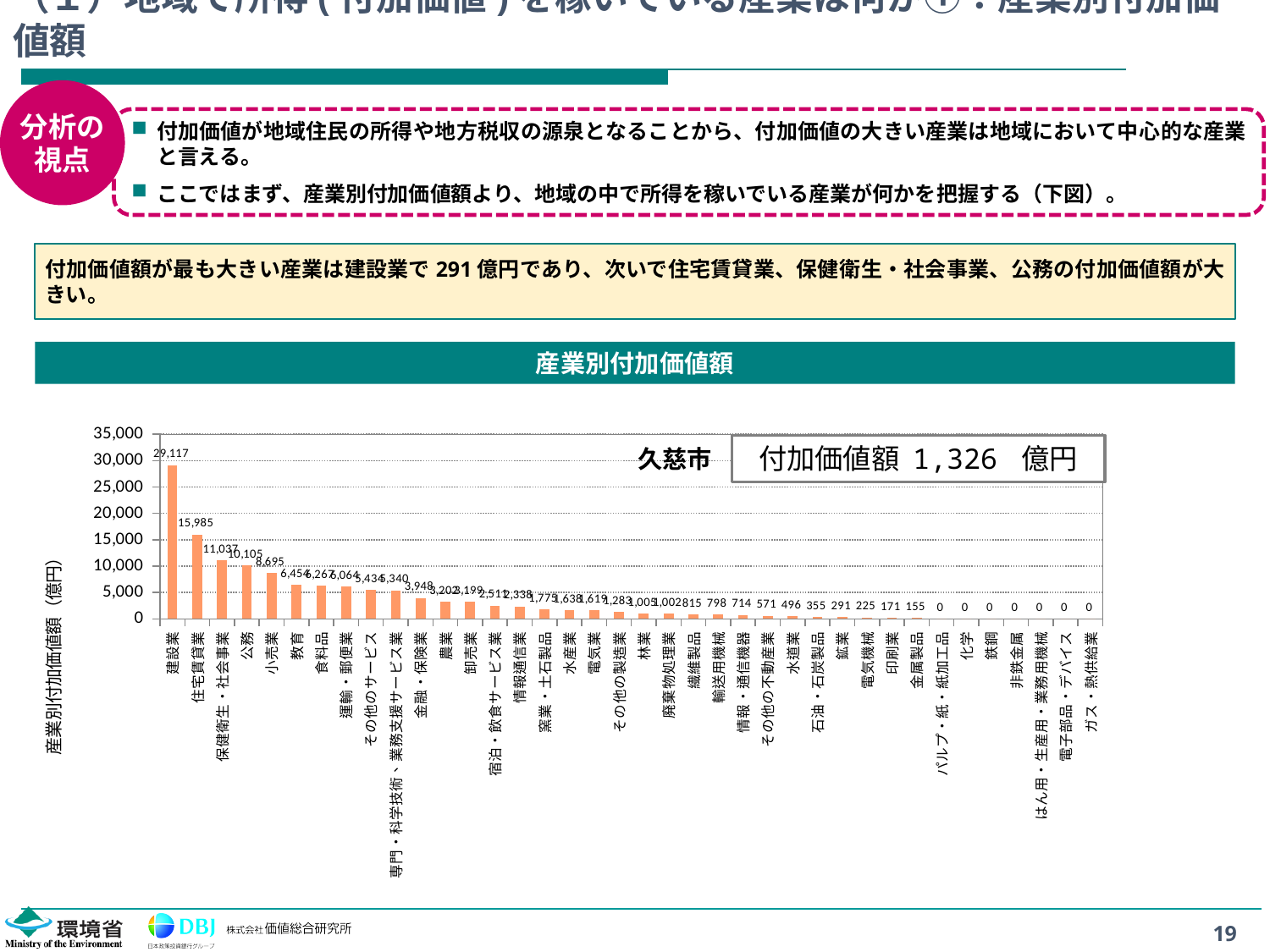
How many industries in the 産業別付加価値額 chart have a value of 0? 7 What is the value for 建設業 in the 産業別付加価値額 chart? 29,117 Do the values in the 産業別付加価値額 chart rise or fall from left to right along the x axis? fall What kind of chart is the 産業別付加価値額 chart? bar chart Is the value for 教育 in the 産業別付加価値額 chart greater or less than 5,000? greater Which industry has the highest value in the 産業別付加価値額 chart? 建設業 In the 産業別付加価値額 chart, which is larger, the value for 公務 or the value for 小売業? 公務 What is the label on the vertical axis of the 産業別付加価値額 chart? 産業別付加価値額（億円） What is the value for 鉱業 in the 産業別付加価値額 chart? 291 What is the value for 水道業 in the 産業別付加価値額 chart? 496 What is the value for 住宅賃貸業 in the 産業別付加価値額 chart? 15,985 What is the difference between the values for 建設業 and 住宅賃貸業 in the 産業別付加価値額 chart? 13,132